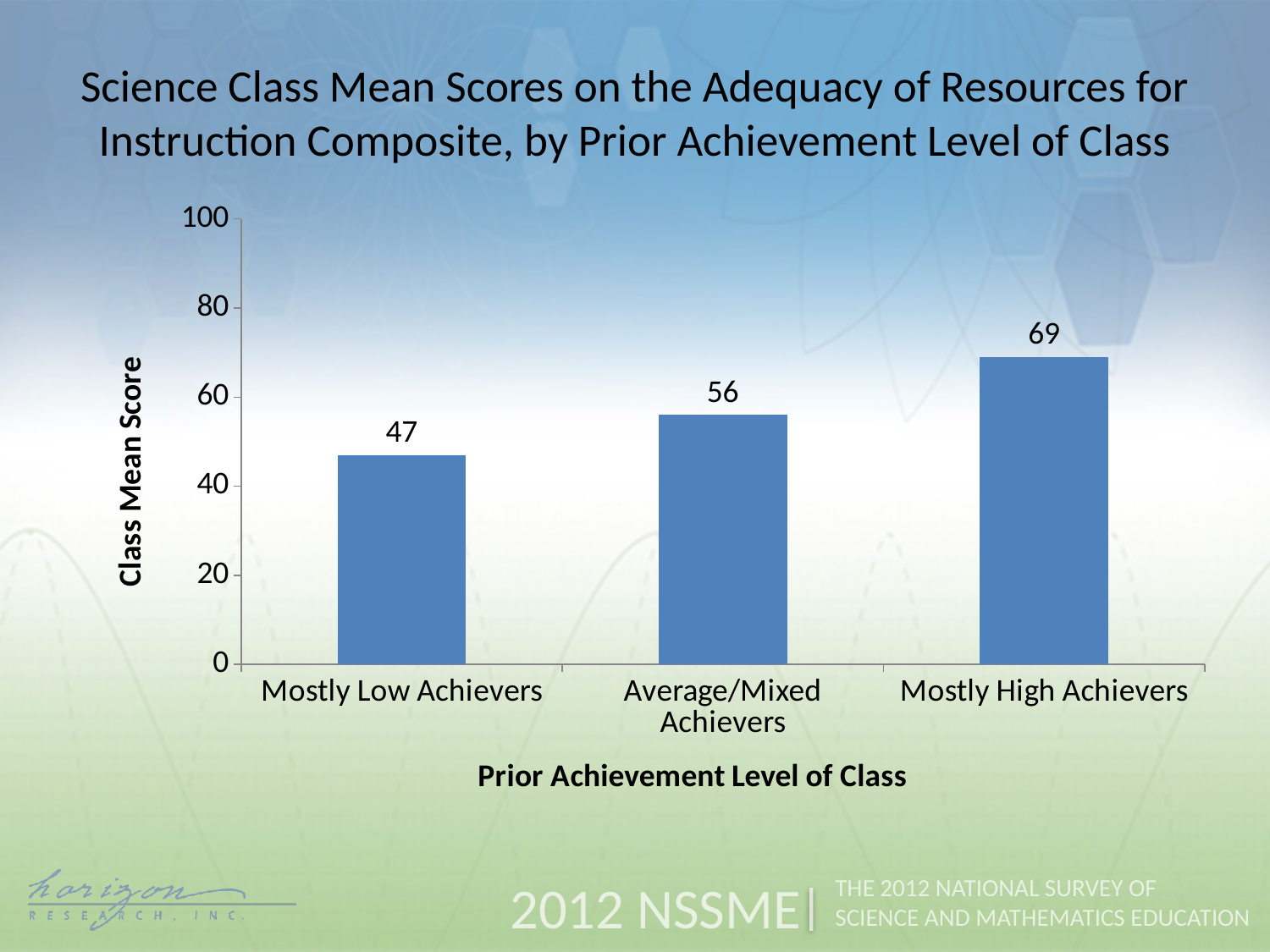
Which prior achievement level has the highest class mean score? Mostly High Achievers What is the class mean score for Mostly High Achievers? 69 How many prior achievement level categories are shown in the chart? 3 What is the class mean score for Mostly Low Achievers? 47 What is the class mean score for Average/Mixed Achievers? 56 Which prior achievement level has the lowest class mean score? Mostly Low Achievers What kind of chart is shown on the slide? bar chart Which has a larger class mean score, Average/Mixed Achievers or Mostly High Achievers? Mostly High Achievers Do the class mean scores rise or fall from Mostly Low Achievers to Mostly High Achievers? rise What is the difference between the class mean scores for Average/Mixed Achievers and Mostly Low Achievers? 9 What is the difference between the class mean scores for Mostly High Achievers and Mostly Low Achievers? 22 Is the class mean score for Mostly Low Achievers greater or less than 60? less